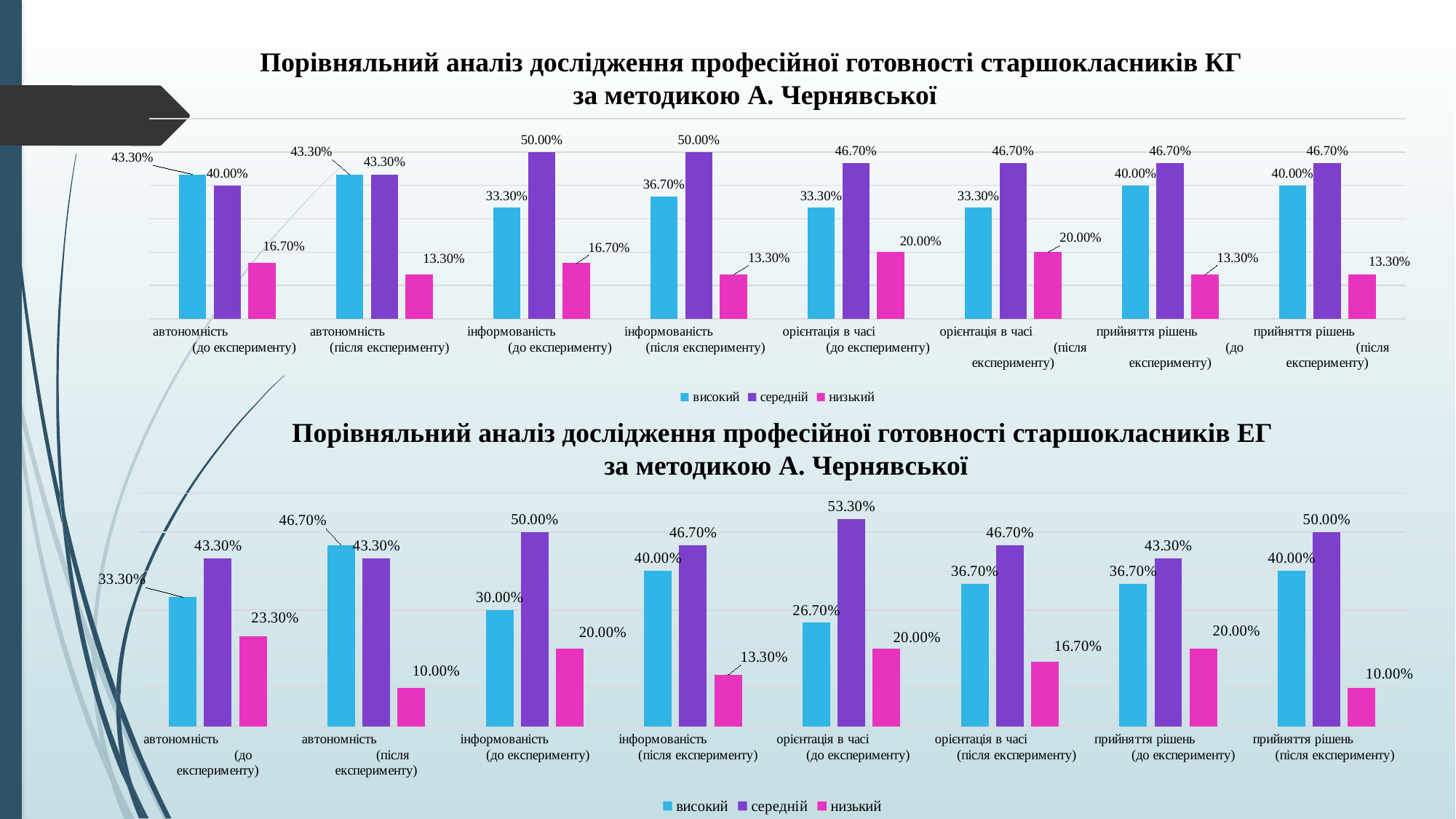
In the bottom chart (ЕГ), what is the total of the three series for 'прийняття рішень (після експерименту)'? 100.00% In the top chart (КГ), what is the value of the 'високий' series for 'інформованість (після експерименту)'? 36.70% In the bottom chart (ЕГ), which category has the highest 'середній' value? орієнтація в часі (до експерименту) In the bottom chart (ЕГ), for 'автономність (після експерименту)', which is larger: the 'високий' value or the 'середній' value? високий In the top chart (КГ), for 'прийняття рішень (до експерименту)', which is larger: the 'високий' value or the 'низький' value? високий In the bottom chart (ЕГ), what is the difference between the 'високий' values for 'автономність (після експерименту)' and 'автономність (до експерименту)'? 13.40% What type of chart is the top chart (КГ)? bar chart How many series does the legend of the bottom chart (ЕГ) list? 3 How many categories are shown on the x axis of the top chart (КГ)? 8 In the top chart (КГ), what is the difference between the 'середній' and 'високий' values for 'інформованість (до експерименту)'? 16.70% In the bottom chart (ЕГ), which category has the lowest 'високий' value? орієнтація в часі (до експерименту) In the bottom chart (ЕГ), what is the value of the 'низький' series for 'автономність (до експерименту)'? 23.30%